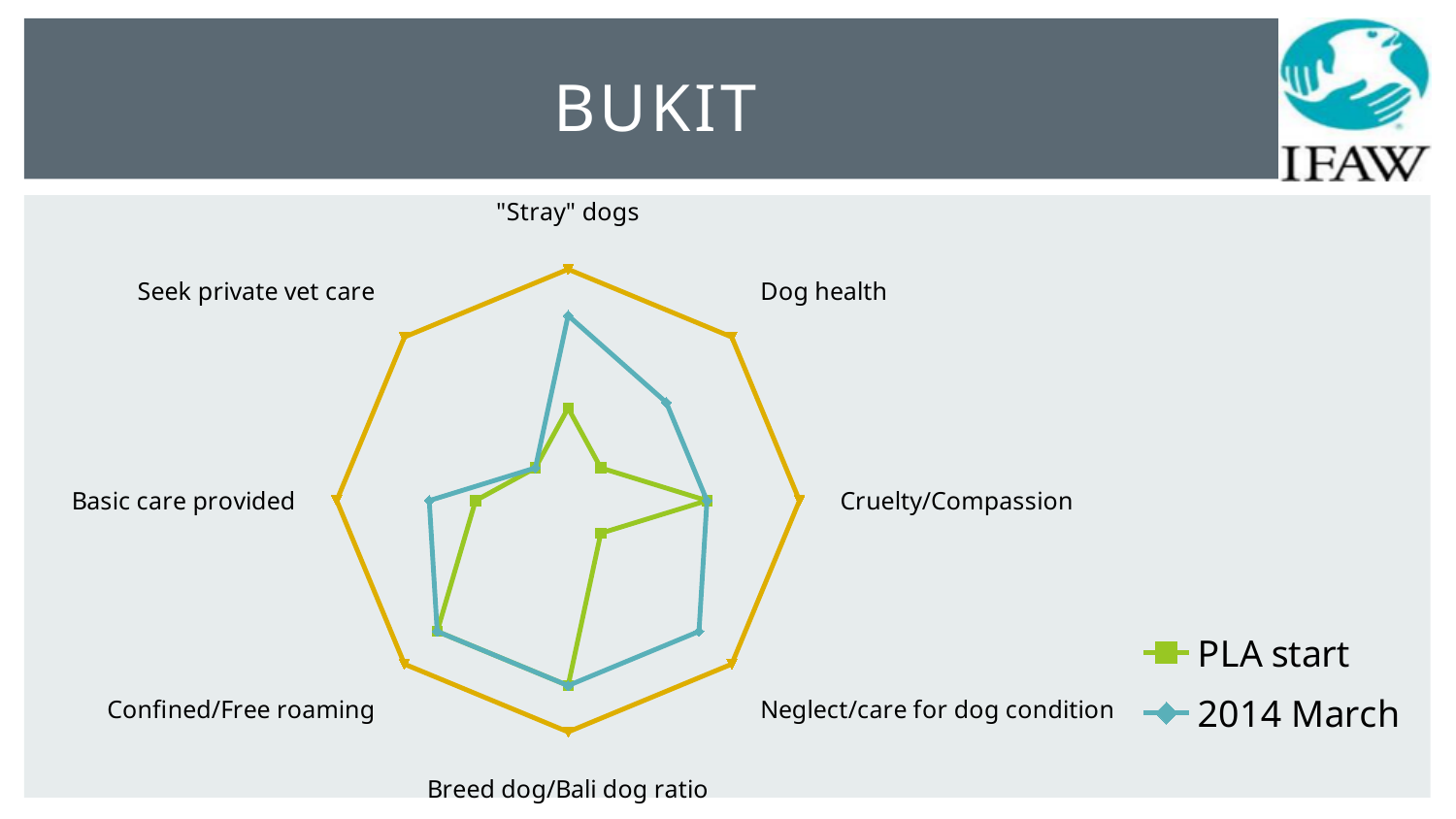
What kind of chart is shown on the slide? Radar chart Which series has the larger value for Dog health, PLA start or 2014 March? 2014 March Which series has the larger value for "Stray" dogs, PLA start or 2014 March? 2014 March Which series has the larger value for Neglect/care for dog condition, PLA start or 2014 March? 2014 March For the 2014 March series, which category has the lowest value? Seek private vet care How many categories (axes) does the radar chart have? 8 What is the title of the slide containing the chart? BUKIT How many series does the legend list? 2 What colour is used for the PLA start series? Green